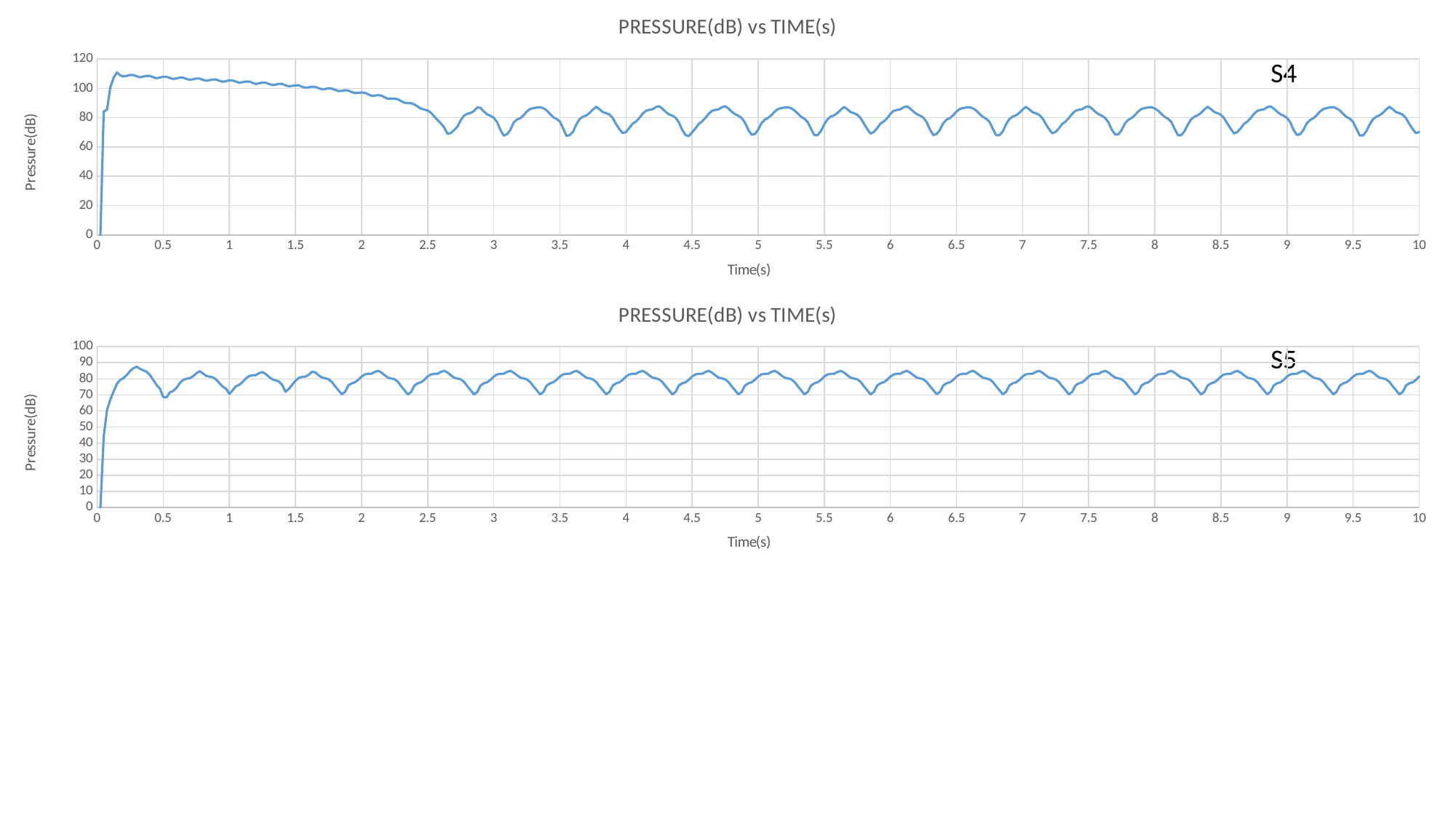
In the top chart (S4), is the pressure value at time 2.5 s greater or less than 100? less How many charts are shown on the slide? 2 What kind of chart is the top chart labelled S4? line chart In the bottom chart (S5), is the highest pressure value reached greater or less than 80? greater In the top chart (S4), does the pressure rise or fall between time 0.5 s and time 2.5 s? fall In the top chart (S4), does the pressure rise or fall between time 0 s and time 0.2 s? rise In the top chart (S4), is the highest pressure value reached greater or less than 100? greater What is the title of the top chart? PRESSURE(dB) vs TIME(s) What kind of chart is the bottom chart labelled S5? line chart What is the highest value shown on the vertical axis of the bottom chart (S5)? 100